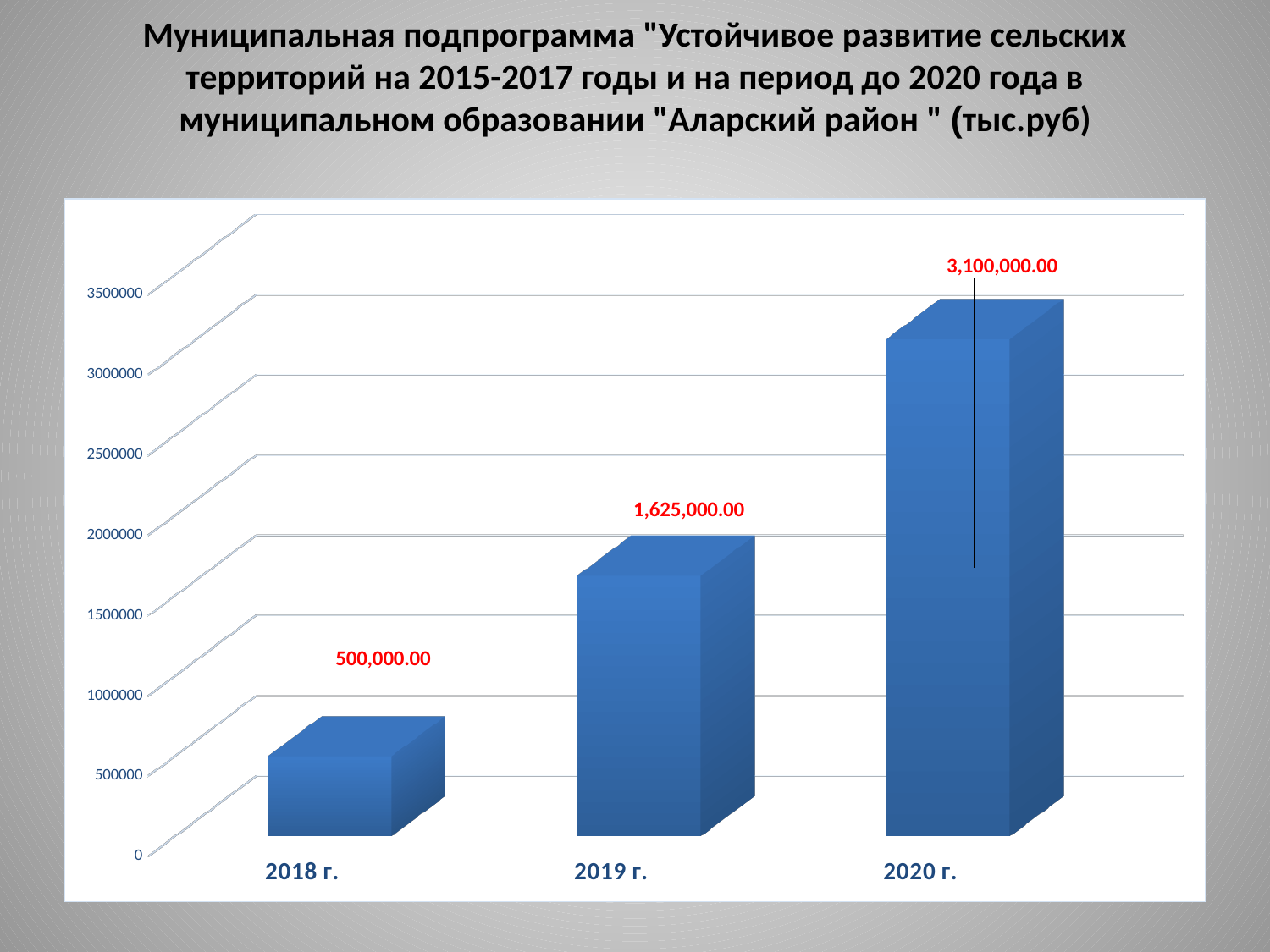
What kind of chart is shown on the slide? bar chart Which year has the highest value? 2020 г. What is the difference between the values for 2019 г. and 2018 г.? 1,125,000.00 What is the difference between the values for 2020 г. and 2019 г.? 1,475,000.00 Which is larger, the value for 2019 г. or the value for 2018 г.? 2019 г. How many years are shown on the x axis? 3 Do the values rise or fall from 2018 г. to 2020 г.? rise Which year has the lowest value? 2018 г. Is the value for 2020 г. greater or less than 3000000? greater What is the value for 2019 г.? 1,625,000.00 What is the value for 2020 г.? 3,100,000.00 What is the value for 2018 г.? 500,000.00